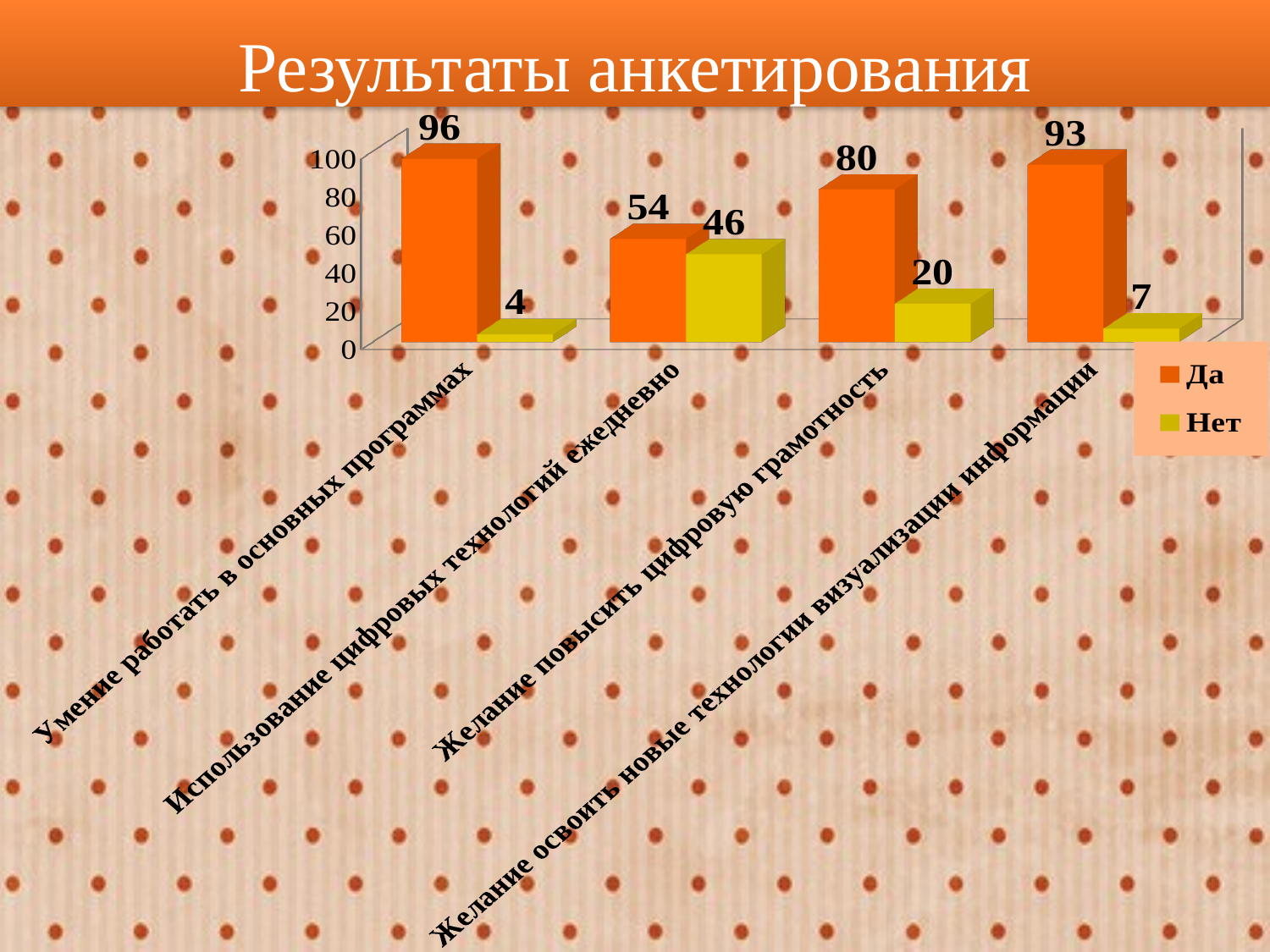
What is the value for "Да" in the category "Умение работать в основных программах"? 96 Which category has the lowest value for "Нет"? Умение работать в основных программах How many series does the legend list? 2 Which category has the highest value for "Да"? Умение работать в основных программах How many categories are shown on the x axis? 4 Which is larger in the category "Использование цифровых технологий ежедневно": "Да" or "Нет"? Да What is the value for "Нет" in the category "Использование цифровых технологий ежедневно"? 46 What is the value for "Нет" in the category "Желание освоить новые технологии визуализации информации"? 7 What kind of chart is shown on the slide? Bar chart What is the value for "Да" in the category "Желание повысить цифровую грамотность"? 80 What is the title of the slide? Результаты анкетирования What is the difference between the "Да" and "Нет" values in the category "Желание повысить цифровую грамотность"? 60